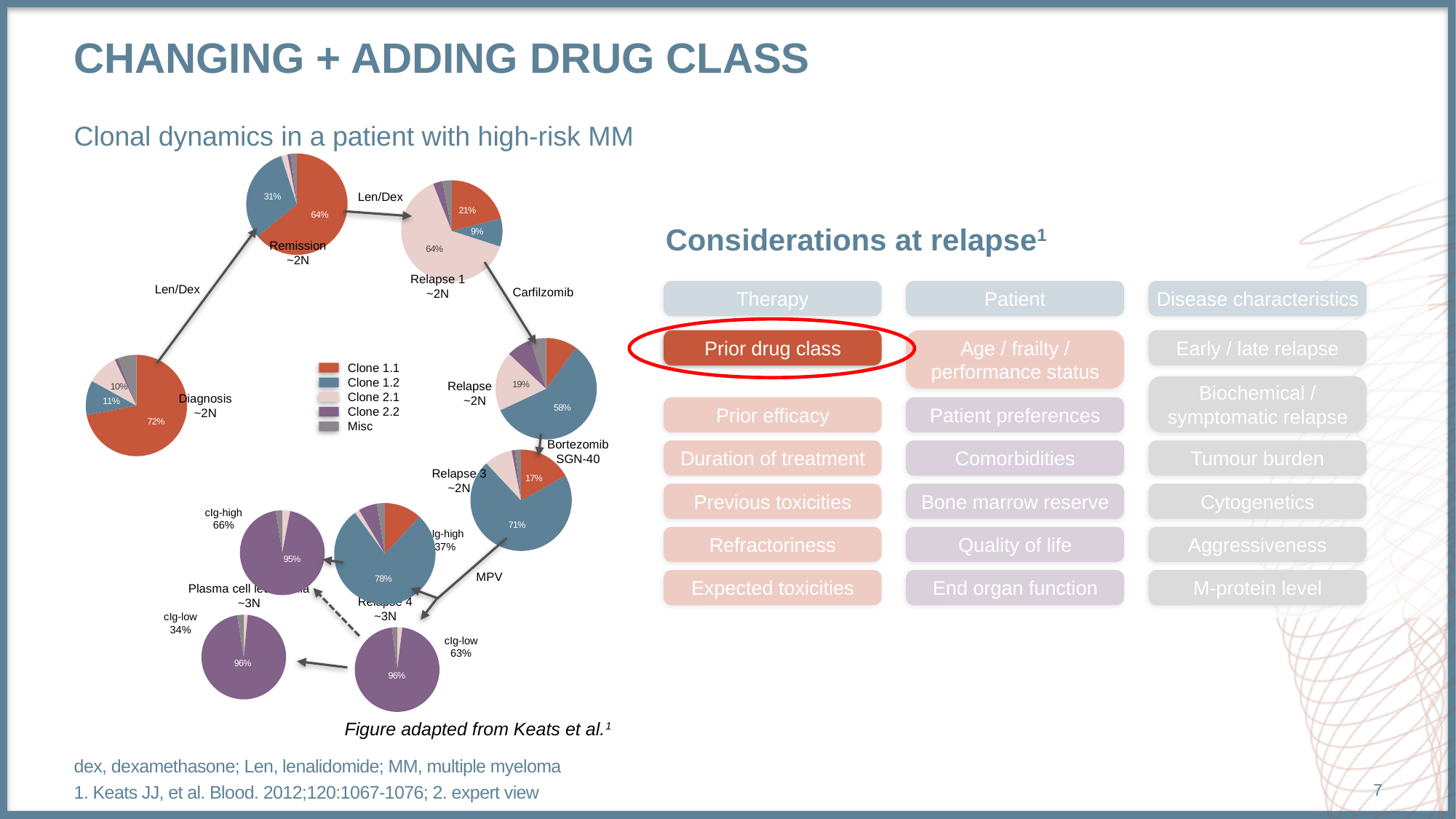
What is the difference between the Clone 1.1 share in the Remission pie (64%) and the Clone 1.1 share in the Relapse 1 pie (21%)? 43 percentage points In the Remission pie chart, what percentage is shown for the Clone 1.2 (blue) slice? 31% In the Relapse 2 pie chart, what percentage is shown for the Clone 1.2 (blue) slice? 58% Which colour represents Clone 2.2 in the legend? Purple In the Diagnosis pie chart, what percentage is labelled for the largest slice (Clone 1.1)? 72% How many entries does the clone legend list? 5 In the Relapse 1 pie chart, what percentage is shown for the Clone 2.1 (light pink) slice? 64% In the Relapse 4 pie chart, what percentage is shown for the Clone 1.2 (blue) slice? 78% In the Relapse 1 pie chart, which labelled slice is smaller: Clone 1.1 (21%) or Clone 1.2 (9%)? Clone 1.2 What kind of charts are used to show the clonal dynamics? Pie charts In the Diagnosis pie chart, which clone has the largest share? Clone 1.1 In the Relapse 3 pie chart, what percentage is shown for the Clone 1.1 (red) slice? 17%